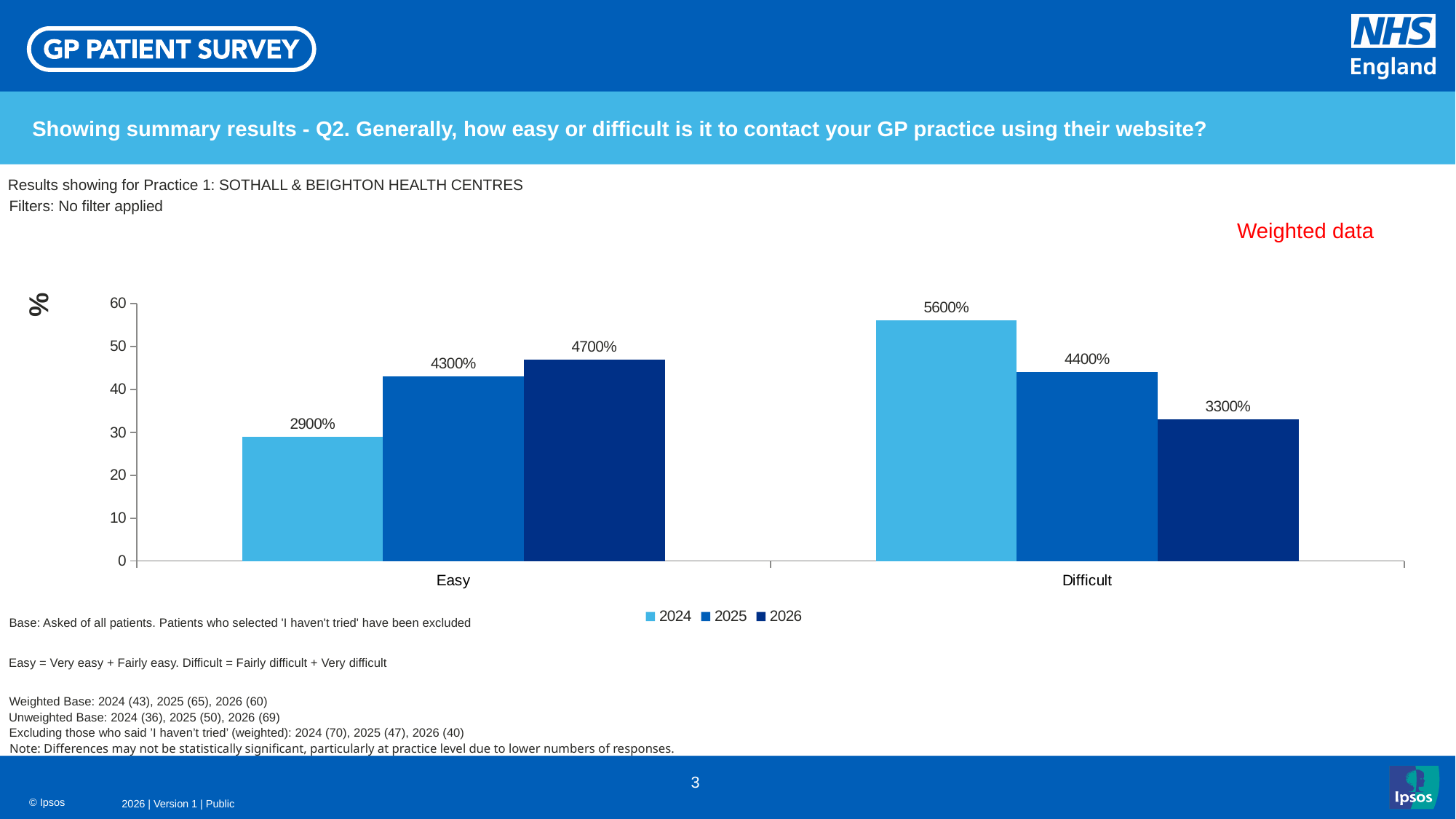
Which is larger in the Difficult category: the 2025 bar or the 2026 bar? 2025 What is the difference between the 2026 and 2024 data labels in the Easy category? 1800% Which year has the lowest bar in the Easy category? 2024 What is the data label for 2026 in the Difficult category? 3300% How many series does the legend list? 3 Do the bars in the Difficult category rise or fall from 2024 to 2026? fall How many categories are shown on the x axis? 2 What is the data label for 2024 in the Easy category? 2900% What is the data label for 2025 in the Easy category? 4300% What kind of chart is shown on the slide? bar chart Is the 2024 bar for Difficult greater or less than 50 on the axis? greater Which year has the highest bar in the Difficult category? 2024